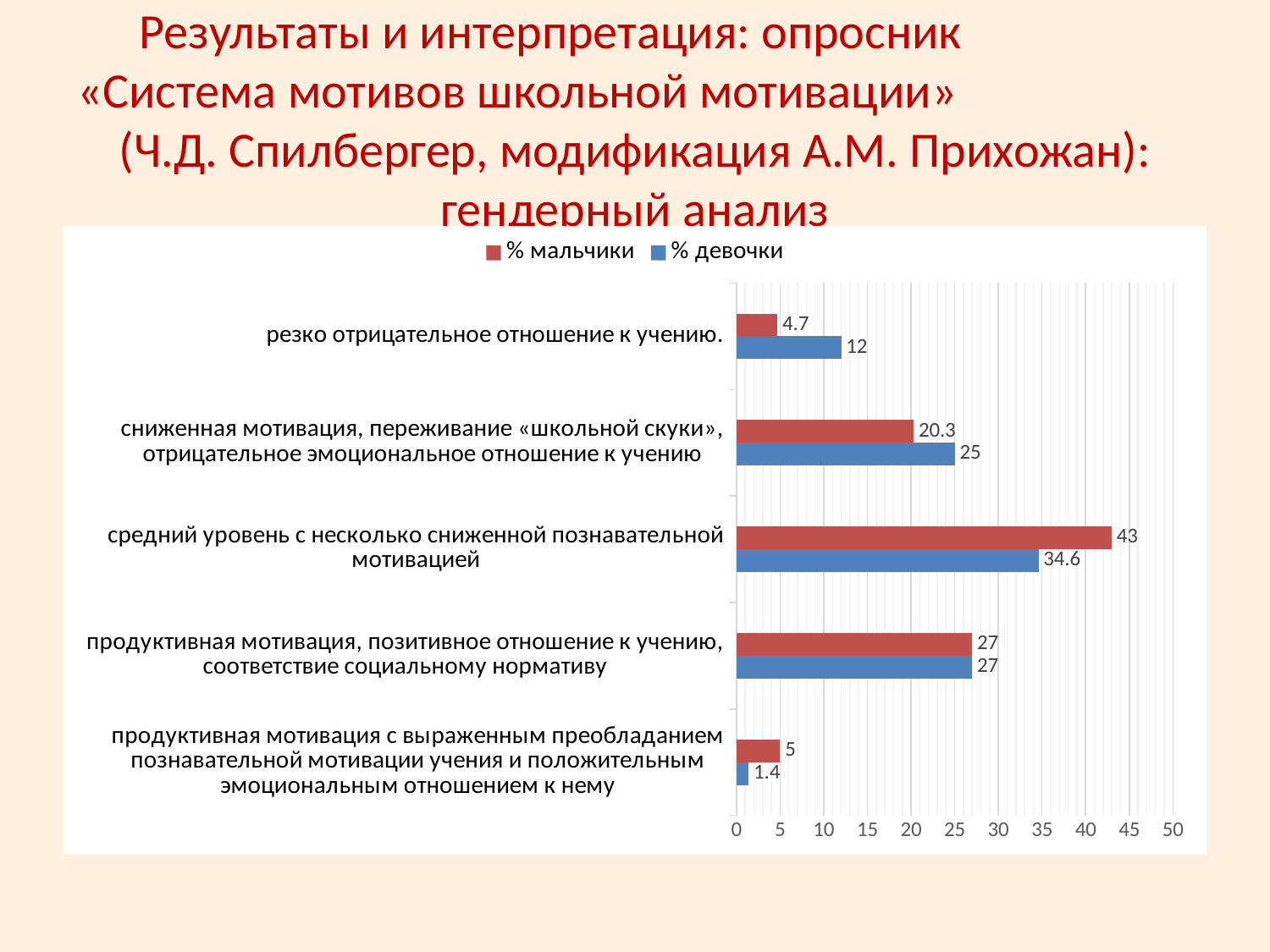
Which category has the highest value for «% мальчики»? средний уровень с несколько сниженной познавательной мотивацией What is the value for «% девочки» in the category «средний уровень с несколько сниженной познавательной мотивацией»? 34.6 Which is larger in the category «резко отрицательное отношение к учению»: «% мальчики» or «% девочки»? % девочки What is the value for «% мальчики» in the category «резко отрицательное отношение к учению»? 4.7 Which category has the lowest value for «% девочки»? продуктивная мотивация с выраженным преобладанием познавательной мотивации учения и положительным эмоциональным отношением к нему How many categories are shown on the chart? 5 What kind of chart is shown on the slide? bar chart What is the value for «% девочки» in the category «сниженная мотивация, переживание «школьной скуки», отрицательное эмоциональное отношение к учению»? 25 Is the value for «% мальчики» in the category «сниженная мотивация, переживание «школьной скуки», отрицательное эмоциональное отношение к учению» greater or less than 25? less What colour are the bars for «% девочки»? blue What is the difference between «% мальчики» and «% девочки» in the category «средний уровень с несколько сниженной познавательной мотивацией»? 8.4 How many series does the legend list? 2